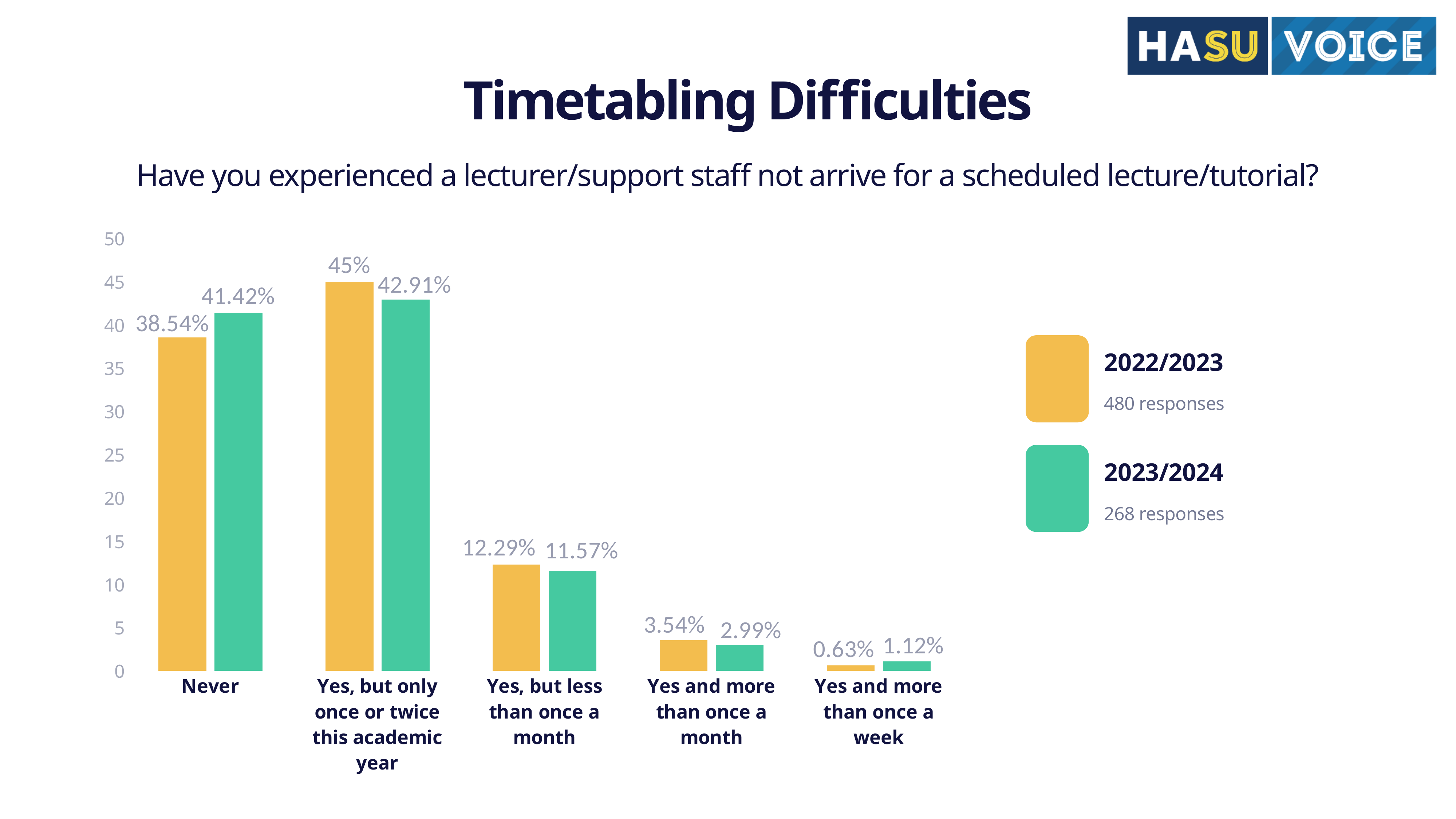
Is the 2022/2023 value for "Yes, but only once or twice this academic year" greater or less than 40? greater For "Yes, but less than once a month", which series has the larger value, 2022/2023 or 2023/2024? 2022/2023 What kind of chart is shown on the slide? Bar chart What percentage of 2022/2023 respondents answered "Never"? 38.54% What is the 2023/2024 value for "Yes and more than once a week"? 1.12% How many response categories are shown on the x axis? 5 How many series does the legend list? 2 What is the difference between the 2022/2023 and 2023/2024 values for "Never"? 2.88% Which category has the highest value for the 2022/2023 series? Yes, but only once or twice this academic year How many responses does the legend give for the 2023/2024 series? 268 responses Which category has the lowest value for the 2023/2024 series? Yes and more than once a week What percentage of 2023/2024 respondents answered "Yes, but only once or twice this academic year"? 42.91%